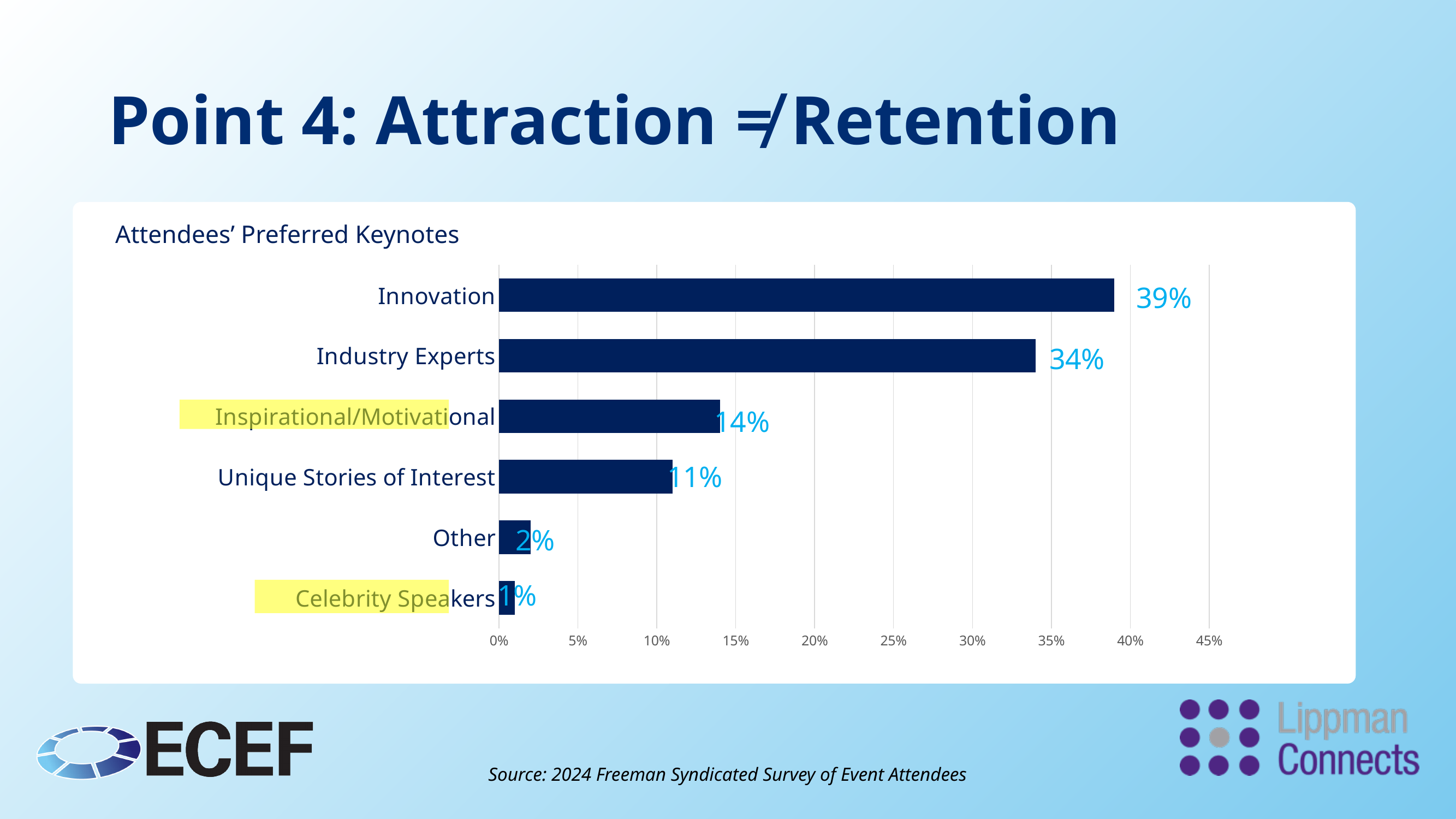
What percentage of attendees prefer Innovation keynotes? 39% Which is larger, the value for Unique Stories of Interest or the value for Other? Unique Stories of Interest What is the difference between the values for Inspirational/Motivational and Unique Stories of Interest? 3% Which keynote type has the lowest percentage? Celebrity Speakers What is the title of the chart? Attendees' Preferred Keynotes How many keynote categories are shown in the chart? 6 Which keynote type has the highest percentage? Innovation What is the value shown for Industry Experts? 34% What is the difference between the values for Innovation and Industry Experts? 5% What is the value shown for Inspirational/Motivational keynotes? 14% What is the value shown for Celebrity Speakers? 1% What kind of chart is shown on the slide? Bar chart